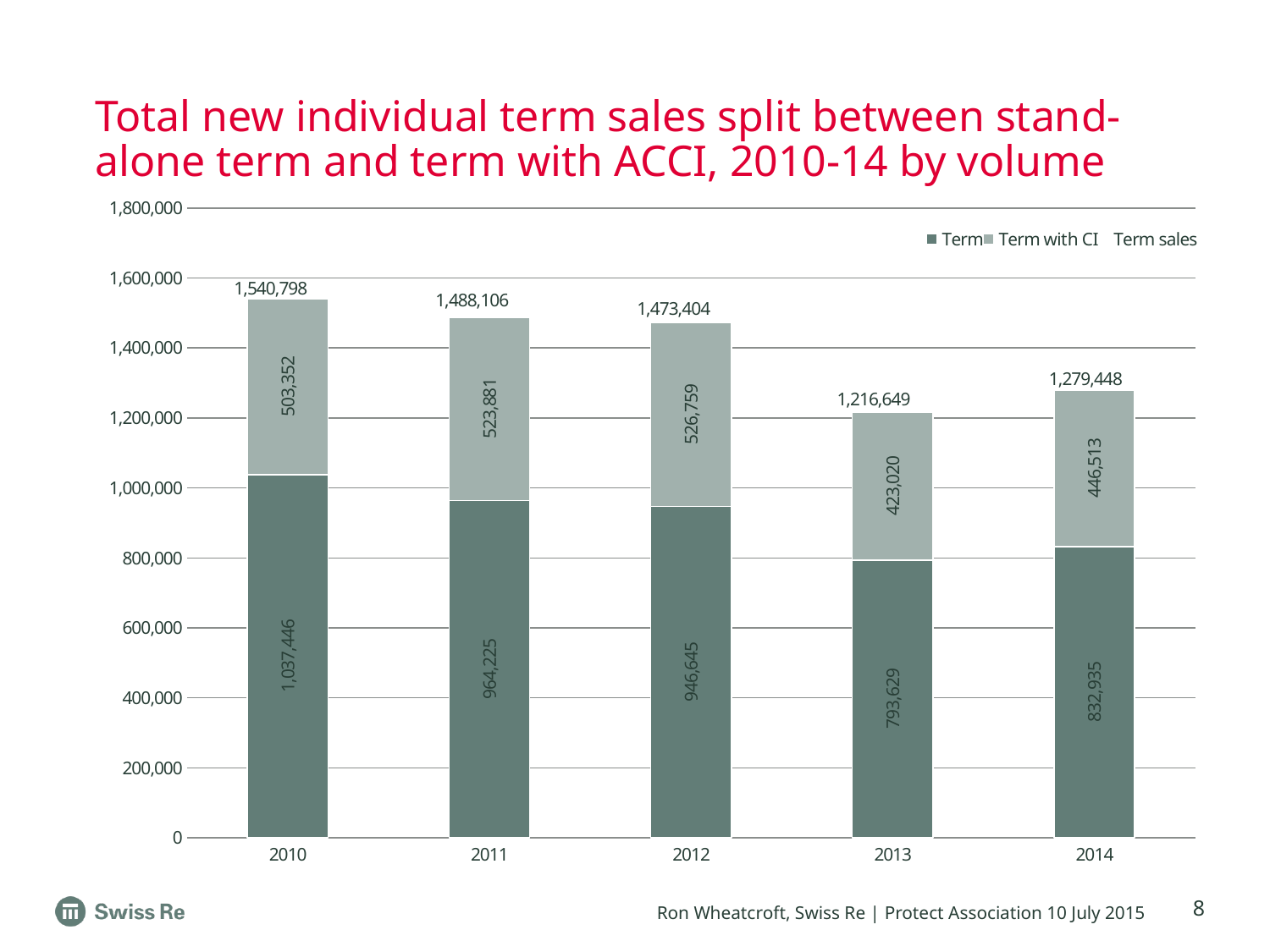
Which is larger, the Term with CI value for 2011 or for 2014? 2011 How many years are shown on the x axis? 5 What is the Term value for 2010? 1,037,446 What is the difference between the Term value in 2010 and the Term value in 2014? 204,511 Which year has the highest total term sales? 2010 Is the total term sales for 2013 greater or less than 1,400,000? less What kind of chart is shown on the slide? Stacked bar chart What is the difference between the Term with CI value in 2012 and in 2013? 103,739 What is the Term with CI value for 2013? 423,020 What is the total term sales figure shown for 2014? 1,279,448 How many entries does the legend list? 3 Which year has the lowest Term value? 2013